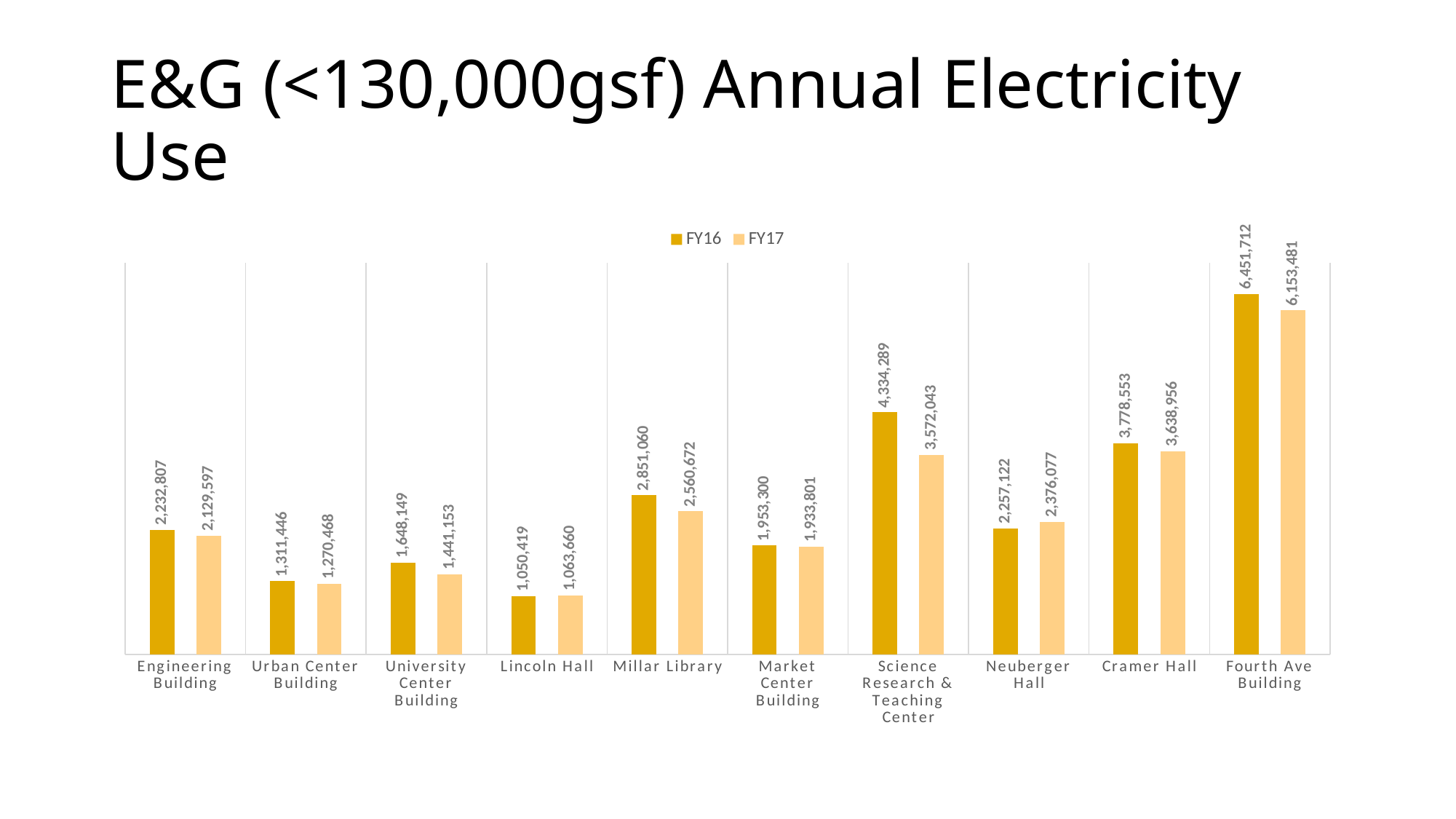
What is the difference between the FY16 and FY17 values for the Science Research & Teaching Center? 762,246 What was the FY16 electricity use for Millar Library? 2,851,060 What was the FY17 electricity use for Neuberger Hall? 2,376,077 What kind of chart is shown on the slide? Bar chart How many buildings are shown on the x axis of the chart? 10 Which building had the lowest FY17 electricity use? Lincoln Hall How many series does the legend list? 2 Which is larger: the FY16 value for Cramer Hall or the FY16 value for Millar Library? Cramer Hall For Neuberger Hall, which is larger: the FY16 value or the FY17 value? FY17 What was the FY17 value for the Science Research & Teaching Center? 3,572,043 Which building had the highest FY16 electricity use? Fourth Ave Building What is the difference between the FY16 and FY17 values for the Fourth Ave Building? 298,231